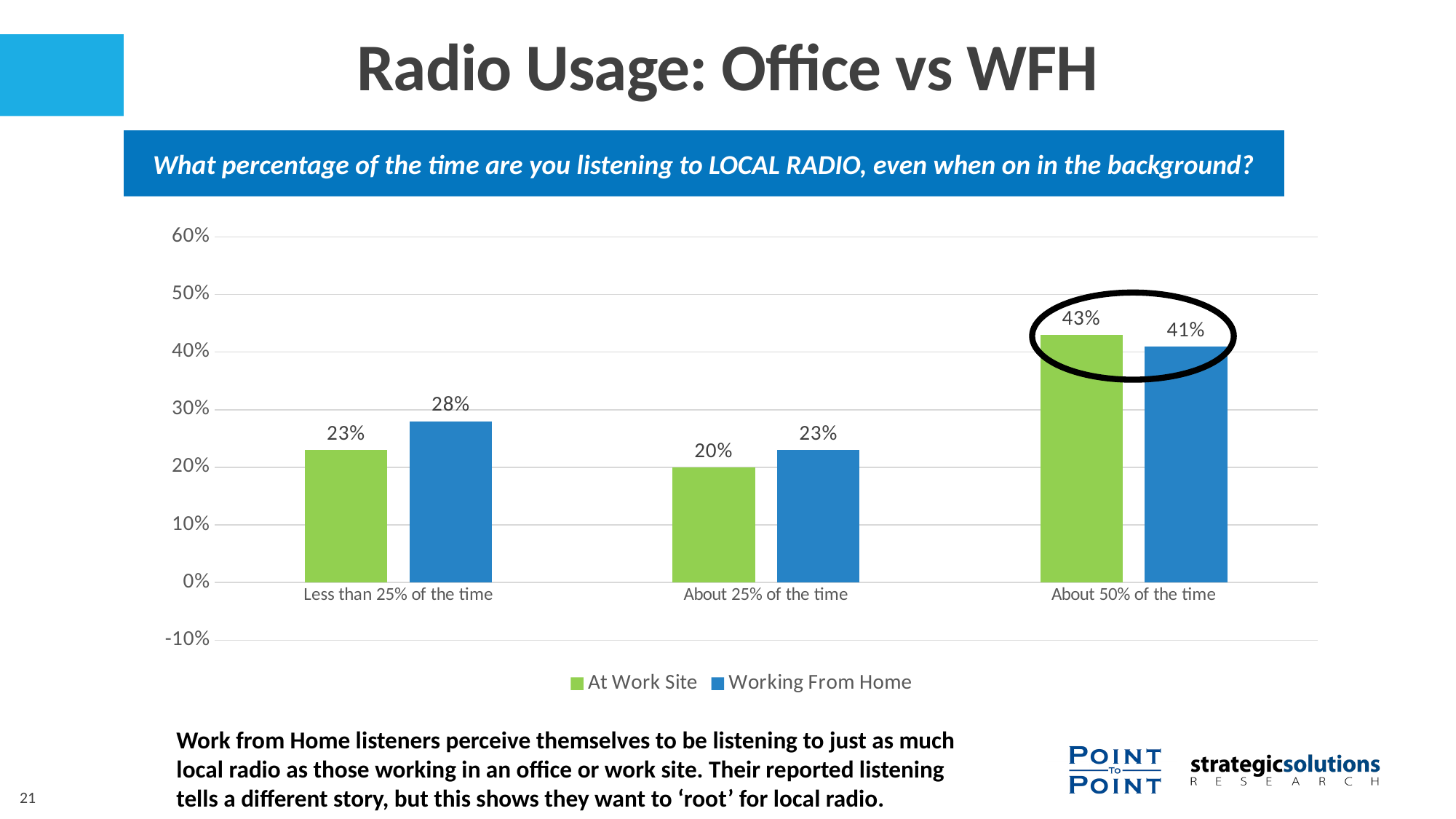
What is the value for Working From Home in the 'About 50% of the time' category? 41% What is the difference between the Working From Home and At Work Site values in the 'Less than 25% of the time' category? 5% Which colour represents the Working From Home series? Blue What is the total of the At Work Site values across all three categories? 86% Which category has the highest value for At Work Site? About 50% of the time How many categories are shown on the x axis? 3 Which category has the lowest value for Working From Home? About 25% of the time In the 'About 25% of the time' category, which series has the larger value, At Work Site or Working From Home? Working From Home What kind of chart is shown on the slide? Bar chart What is the value for Working From Home in the 'About 25% of the time' category? 23% How many series does the legend list? 2 What is the value for At Work Site in the 'Less than 25% of the time' category? 23%